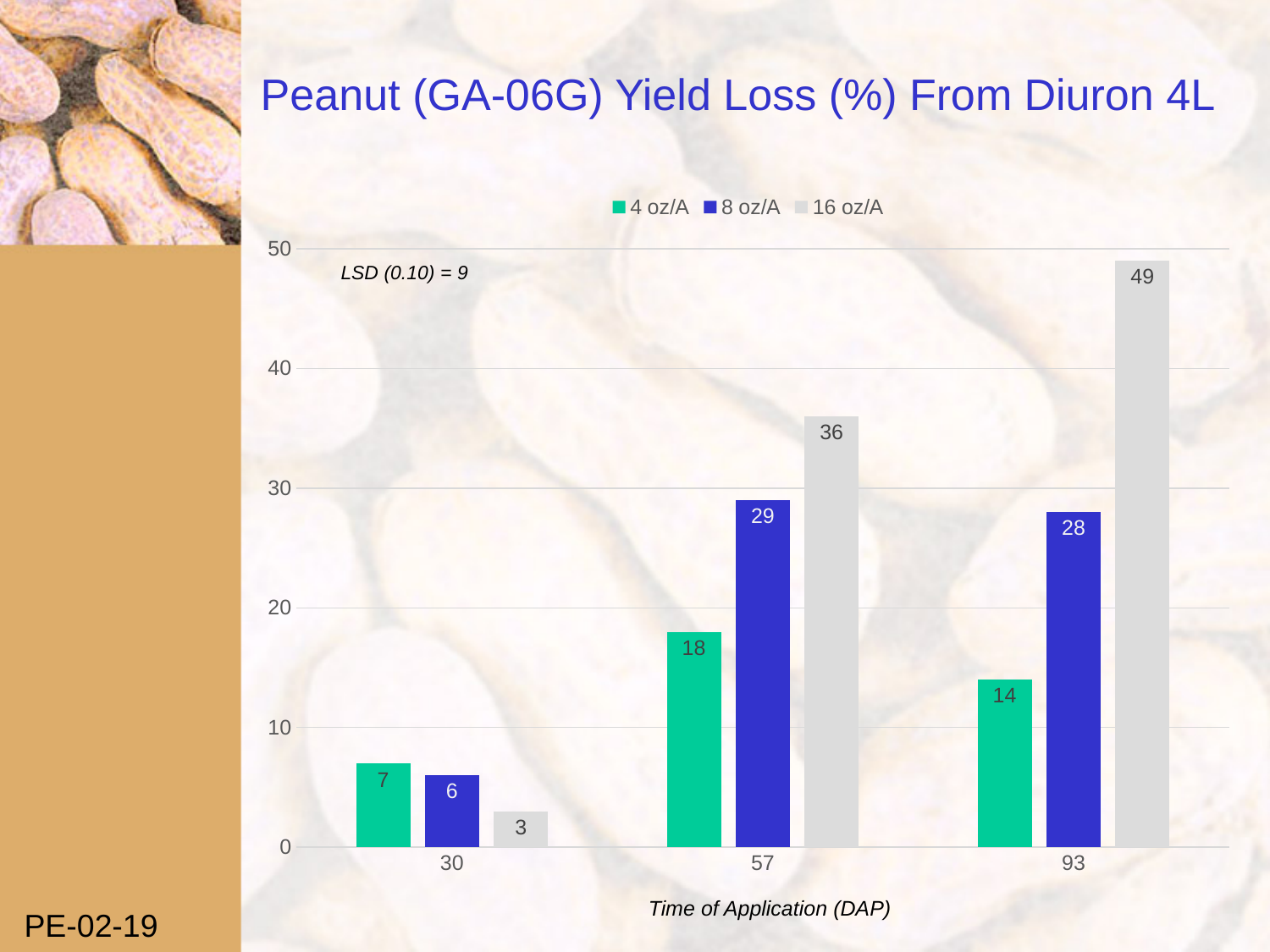
Which time of application has the lowest yield loss for 8 oz/A? 30 What is the LSD (0.10) value noted on the chart? 9 What is the difference between the 16 oz/A and 4 oz/A yield loss at 93 DAP? 35 What kind of chart is shown on the slide? bar chart Is the yield loss for 8 oz/A at 57 DAP greater or less than 20? greater What is the yield loss for 16 oz/A at 57 DAP? 36 How many series does the legend list? 3 What is the yield loss for 8 oz/A at 30 DAP? 6 How many times of application are shown on the x axis? 3 Which is larger at 30 DAP: the yield loss for 4 oz/A or for 16 oz/A? 4 oz/A Which time of application has the highest yield loss for 16 oz/A? 93 What is the yield loss for 4 oz/A at 93 DAP? 14